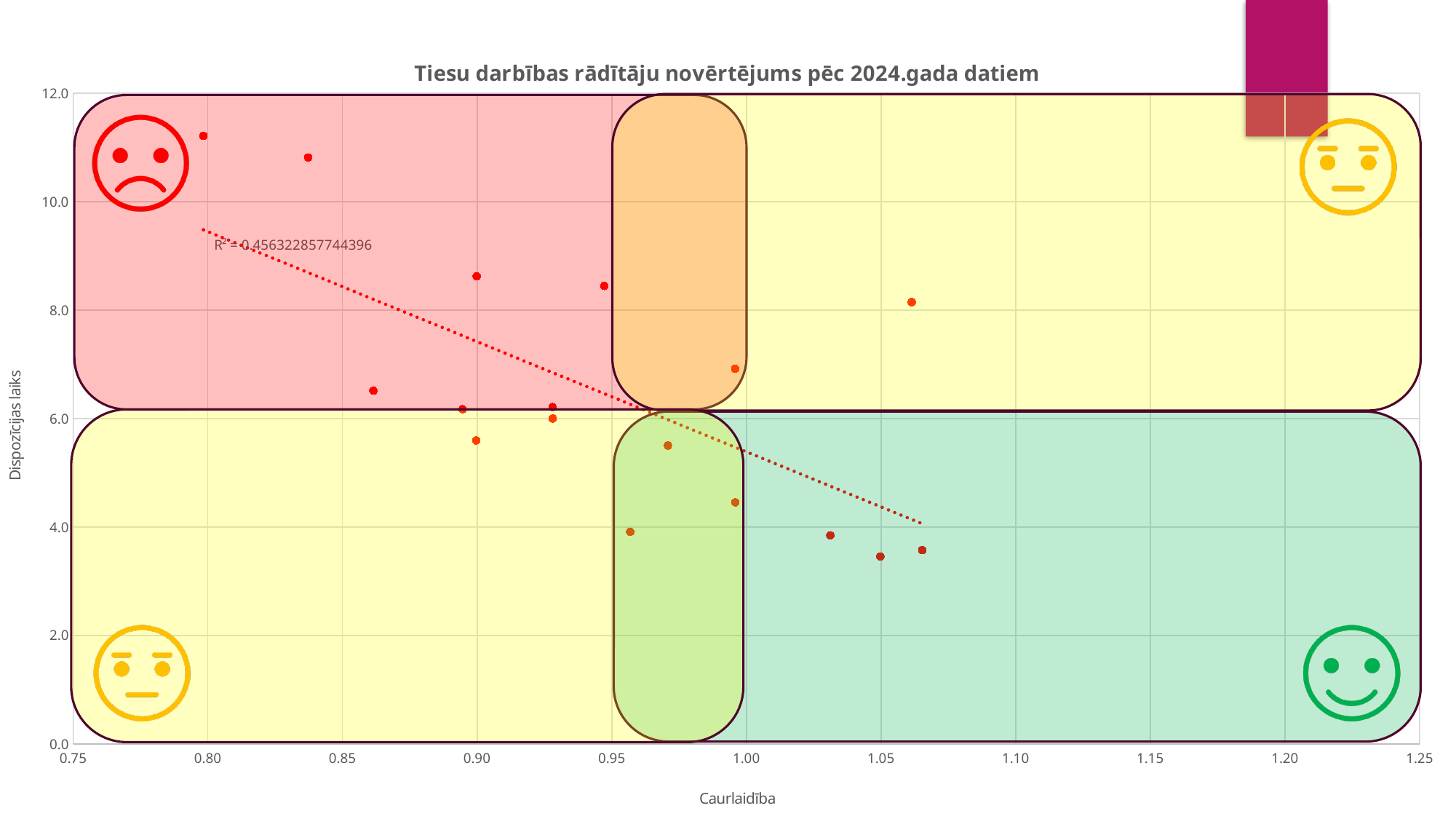
What kind of chart is shown on the slide? scatter chart Is the highest Dispozīcijas laiks value plotted greater or less than 10.0? greater Does the dotted trend line rise or fall as Caurlaidība increases? fall Are there any points plotted with Caurlaidība greater than 1.10? No What is the maximum value shown on the y axis? 12.0 What is the title of the chart? Tiesu darbības rādītāju novērtējums pēc 2024.gada datiem Is the lowest Dispozīcijas laiks value plotted greater or less than 4.0? less What R² value is printed on the chart? R² = 0.456322857744396 What is the label of the x axis? Caurlaidība